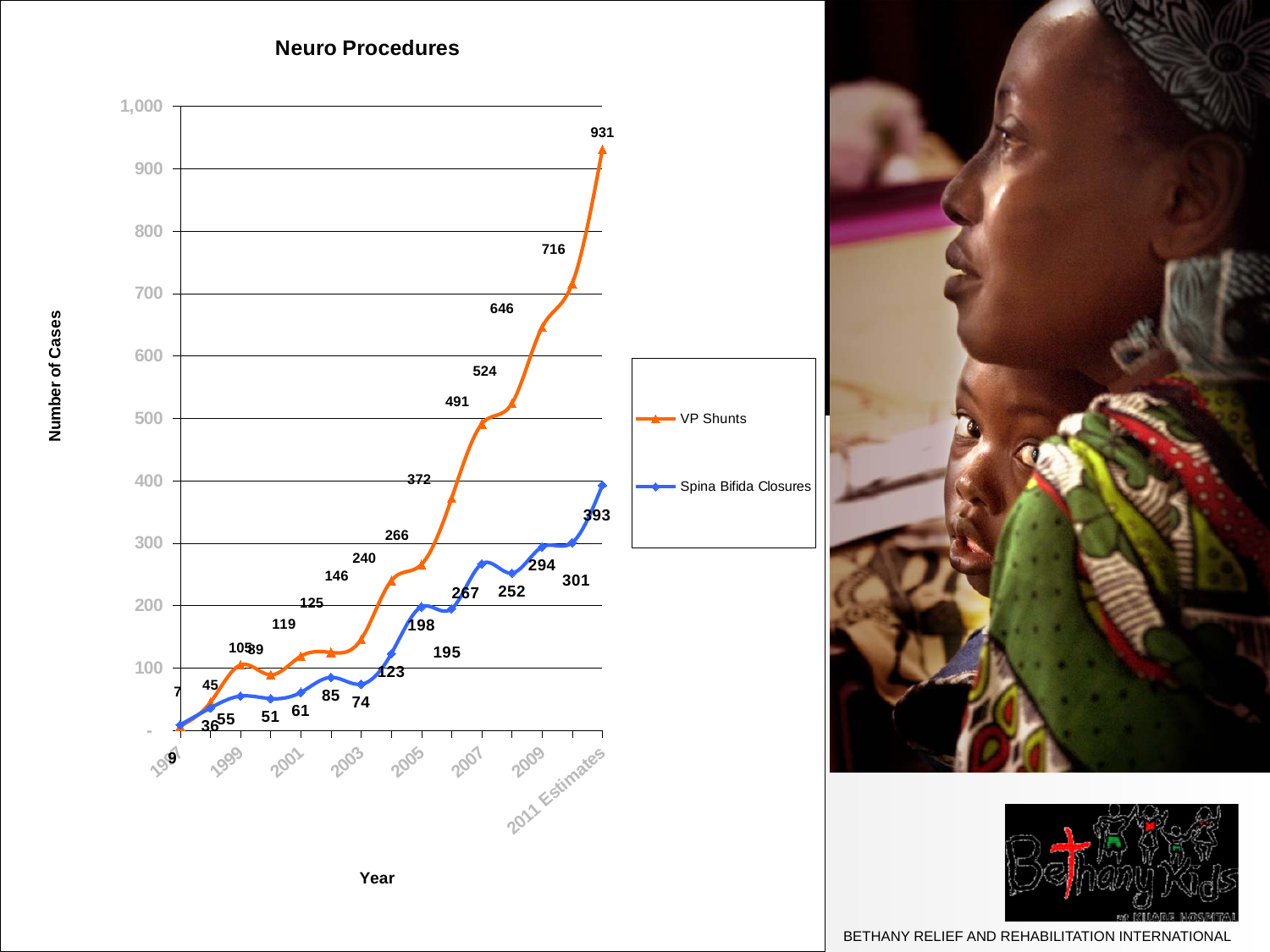
In which year is the VP Shunts value highest? 2011 Estimates How many series does the legend list? 2 Do the VP Shunts values generally rise or fall from 1997 to 2011 Estimates? rise In 2007, which series has the larger value, VP Shunts or Spina Bifida Closures? VP Shunts What type of chart is shown on the slide? line chart What is the difference between VP Shunts and Spina Bifida Closures in 2011 Estimates? 538 What is the value for Spina Bifida Closures in 2011 Estimates? 393 In which year is the VP Shunts value lowest? 1997 What is the value for Spina Bifida Closures in 2009? 294 What is the value for VP Shunts in 2009? 646 What is the title of the vertical axis? Number of Cases What is the value for VP Shunts in 2011 Estimates? 931